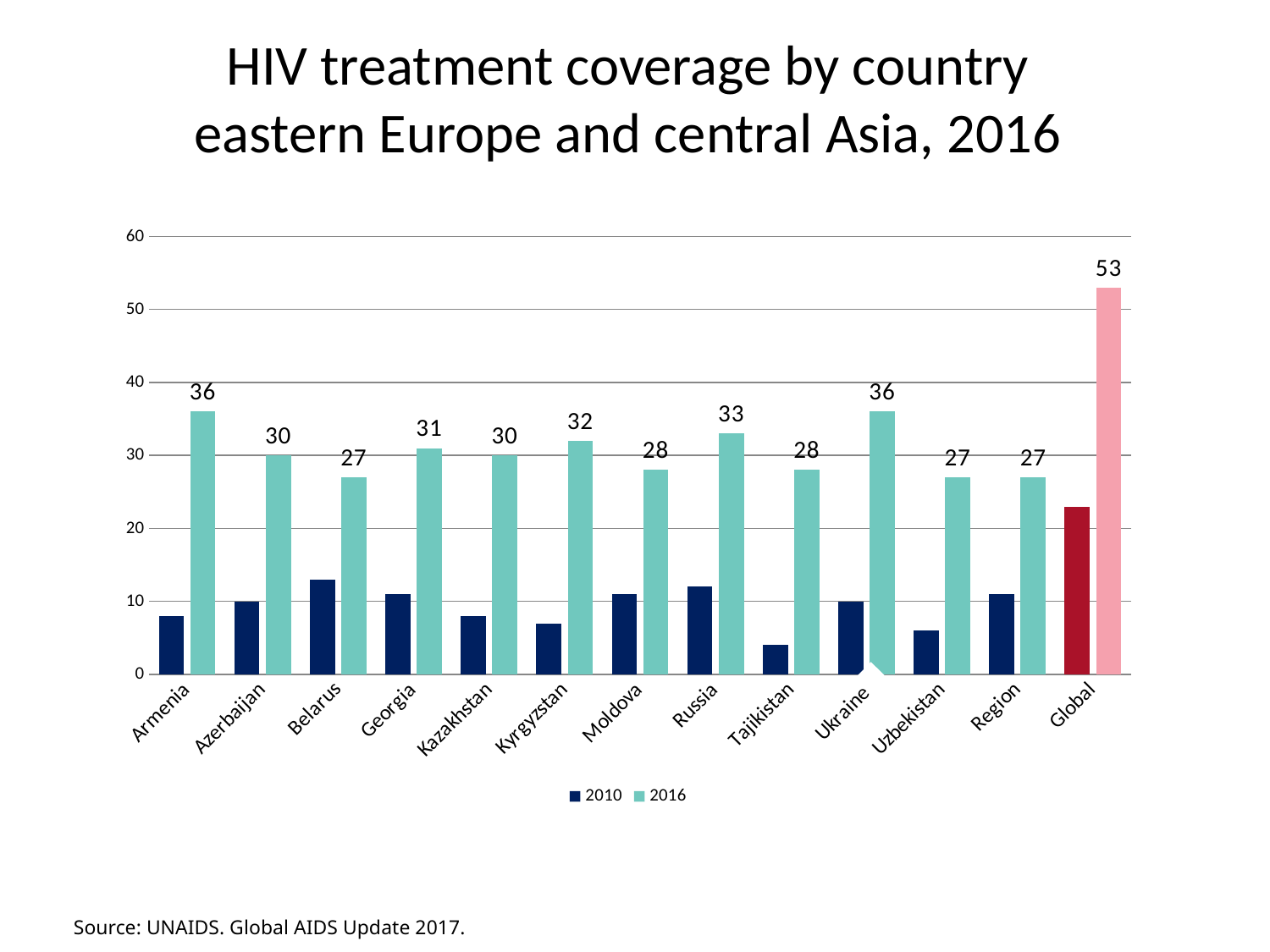
Which has the larger 2016 value, Kyrgyzstan or Georgia? Kyrgyzstan Which category has the highest 2016 value? Global How many categories are shown on the x axis? 13 Is the 2010 value for Belarus greater or less than 10? greater How many series does the legend list? 2 What is the 2016 value shown for Russia? 33 What kind of chart is shown on the slide? bar chart Is the 2010 value for Tajikistan greater or less than 10? less What is the 2016 HIV treatment coverage value for Armenia? 36 What is the 2016 value shown for Global? 53 What is the difference between the 2016 values for Global and Region? 26 What is the difference between the 2016 values for Russia and Moldova? 5